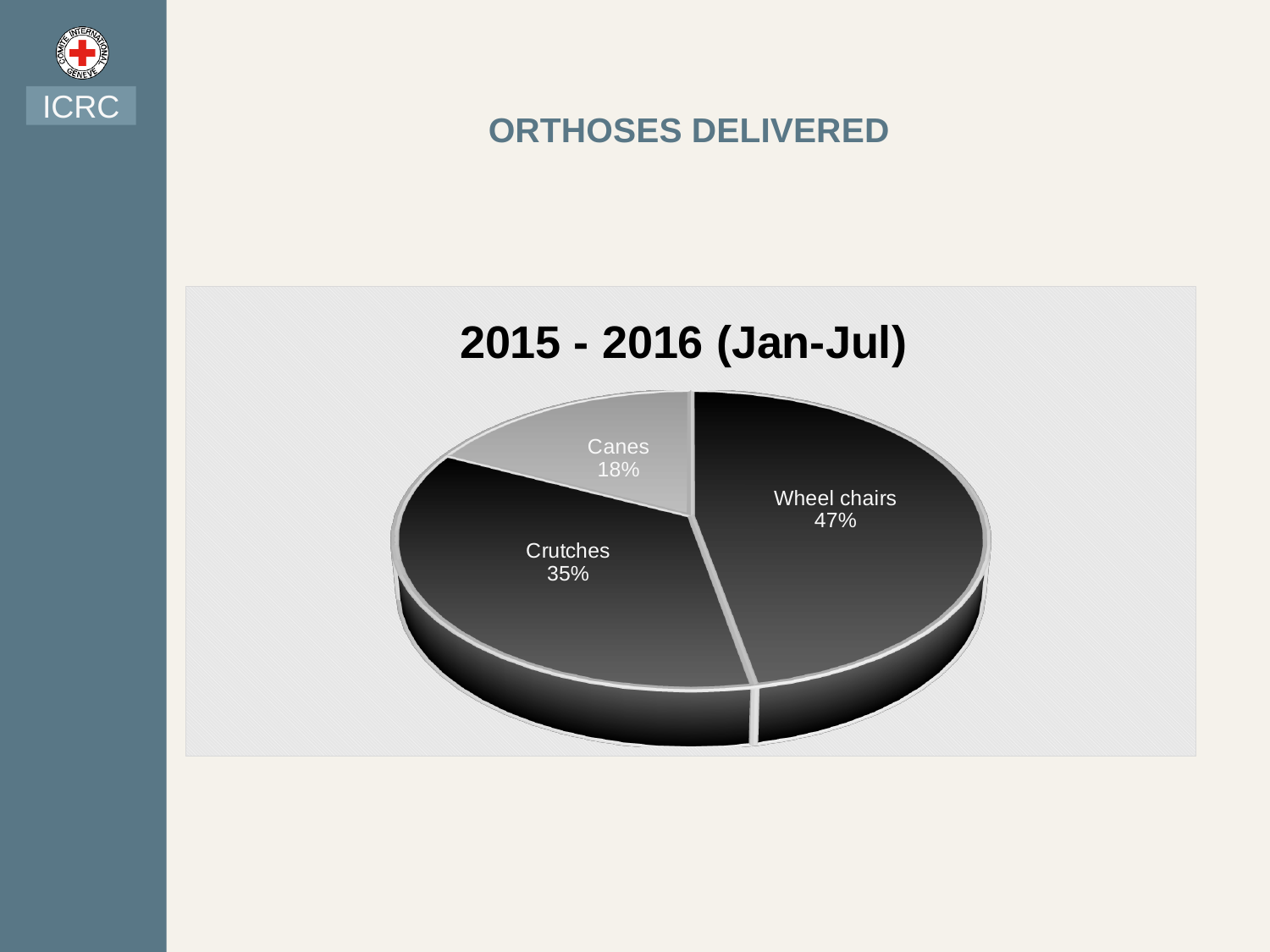
What is the title of the chart? 2015 - 2016 (Jan-Jul) What share of the pie does Canes have? 18% Which is larger, the share for Crutches or the share for Canes? Crutches Which slice of the pie is the lightest in colour? Canes What share of the pie does Wheel chairs have? 47% How many categories are shown in the pie chart? 3 What share of the pie does Crutches have? 35% What is the difference in percentage points between Wheel chairs and Crutches? 12 What kind of chart is shown on the slide? Pie chart What is the difference in percentage points between Crutches and Canes? 17 Which category has the smallest slice of the pie? Canes Which category has the largest slice of the pie? Wheel chairs